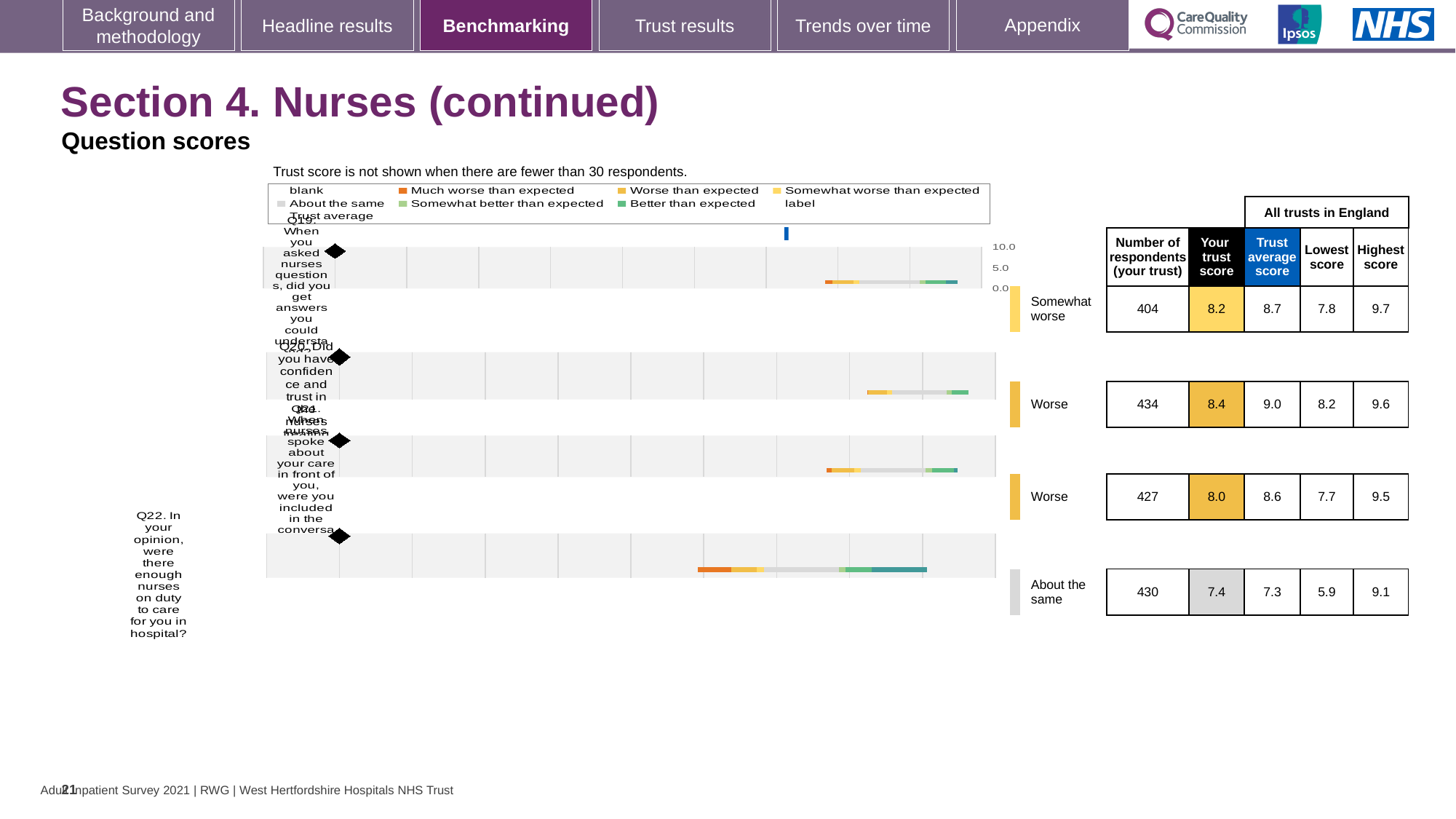
How many questions are plotted on the chart? 4 Which question has the lowest trust score for this trust? Q22 How many respondents answered Q20 (confidence and trust in the nurses) at this trust? 434 Which question has the highest trust score for this trust? Q20 What is the trust average score for Q21 (were you included in the conversation when nurses spoke about your care)? 8.6 What is the lowest score across all trusts in England for Q22? 5.9 What is the highest score across all trusts in England for Q19 (did you get answers you could understand)? 9.7 What benchmark category is shown for Q22? About the same For Q22, which is larger: this trust's score or the trust average score? This trust's score What kind of chart is used to show the question scores? Bar chart What is the difference between the trust average score and this trust's score for Q19? 0.5 What is the trust score for Q22 (were there enough nurses on duty to care for you in hospital)? 7.4